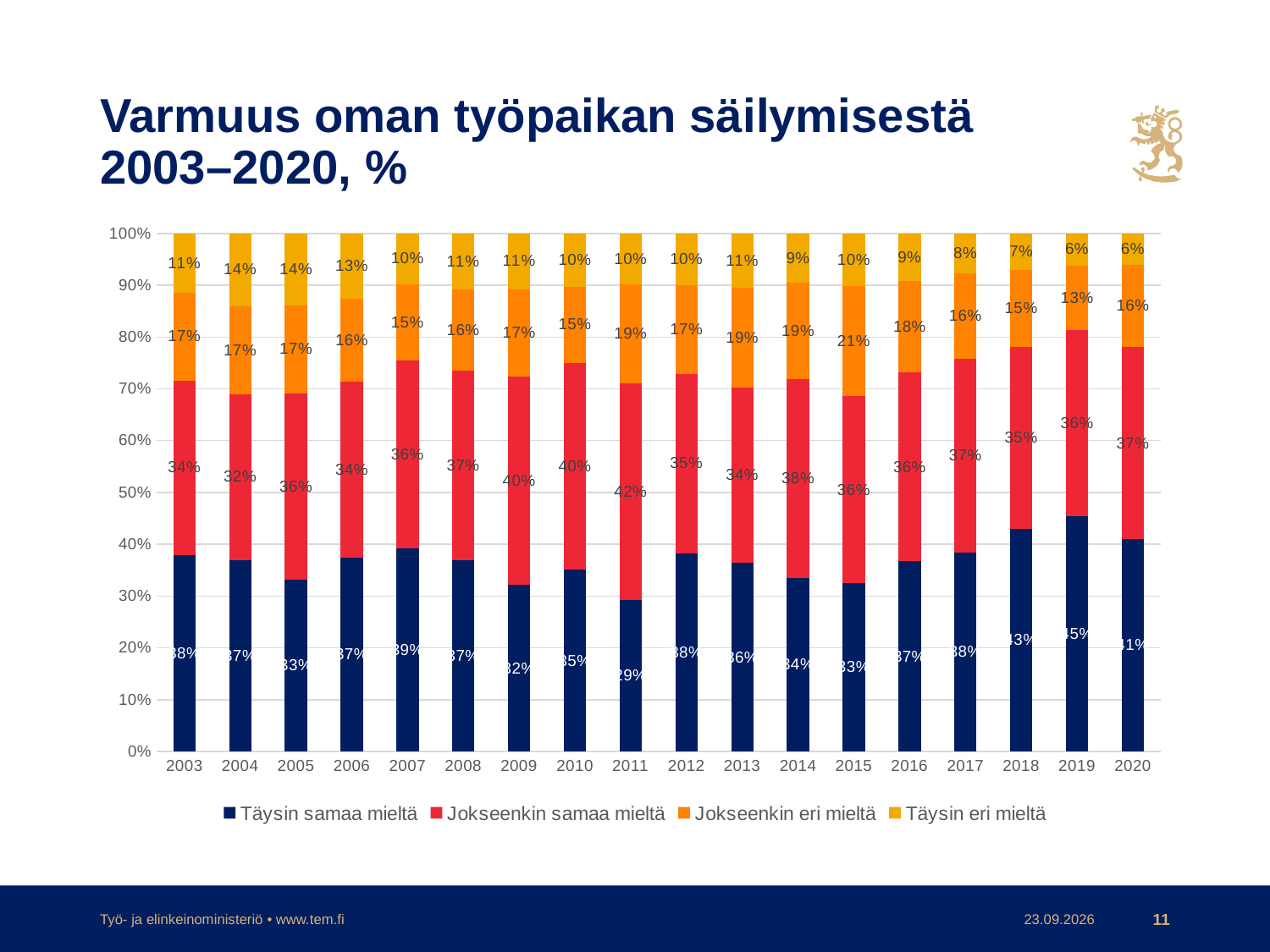
Does the Täysin eri mieltä share rise or fall from 2015 to 2020? Fall What kind of chart is shown on the slide? Stacked bar chart What is the value for Täysin eri mieltä in 2003? 11% How many years are shown on the x axis? 18 What is the difference between the Täysin eri mieltä share in 2004 and in 2020? 8 percentage points Which year has a larger Jokseenkin eri mieltä share, 2007 or 2011? 2011 What is the value for Jokseenkin eri mieltä in 2015? 21% What is the title of the chart? Varmuus oman työpaikan säilymisestä 2003–2020, % How many series does the legend list? 4 In which year is the Täysin samaa mieltä share lowest? 2011 What is the value for Jokseenkin samaa mieltä in 2009? 40% In which year is the Jokseenkin samaa mieltä share highest? 2011